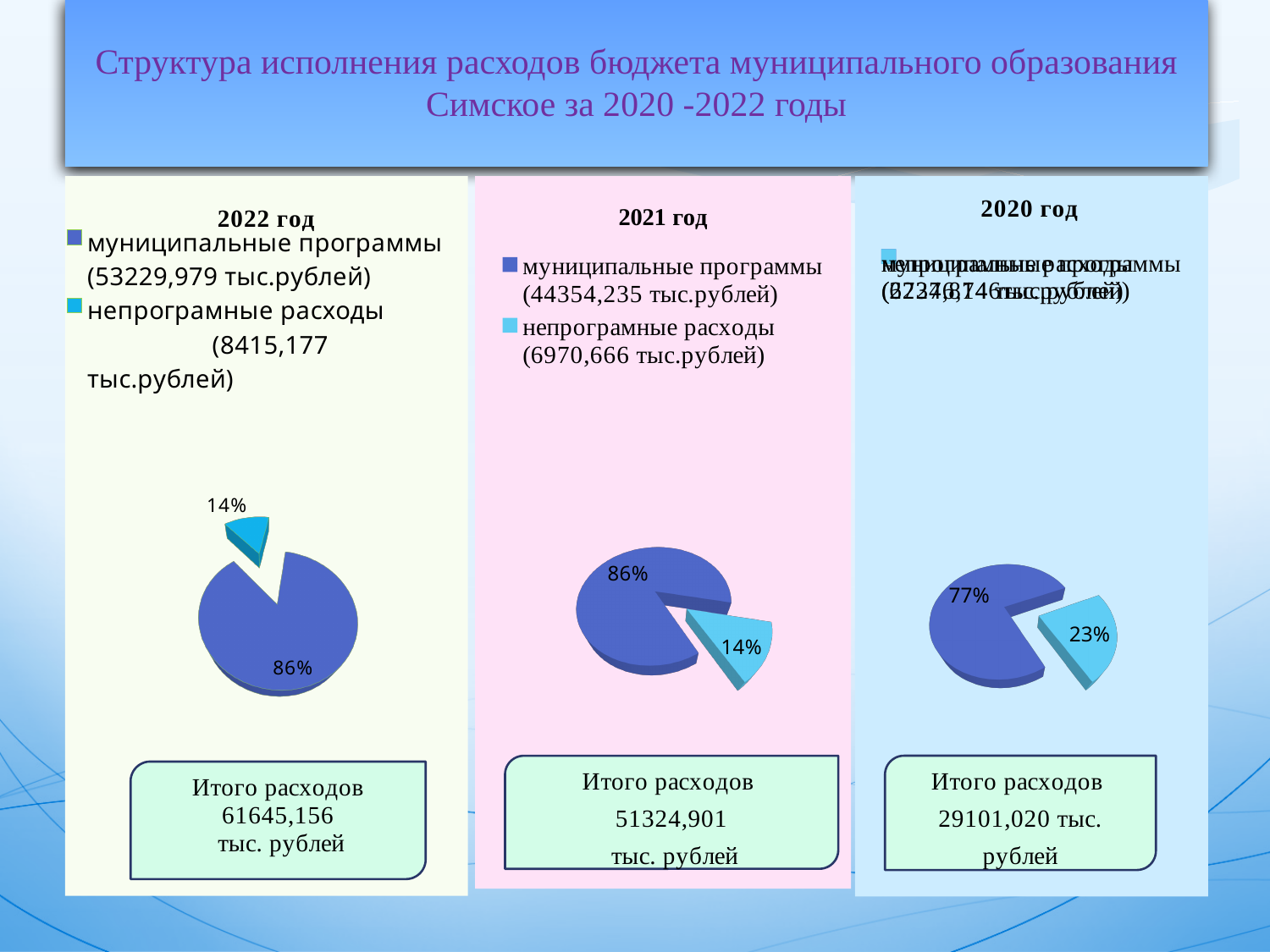
In the 2022 год pie chart, what share is shown for муниципальные программы? 86% In the 2022 год pie chart, what share is shown for непрограмные расходы? 14% In the 2020 год pie chart, what share is shown for the smaller slice? 23% What is the difference in percentage points between the two slices of the 2020 год pie chart? 54 In the 2020 год pie chart, which slice is larger, 77% or 23%? 77% What kind of chart is used for the 2022 год panel? pie chart According to the 2022 год legend, what is the value for муниципальные программы? 53229,979 тыс.рублей How many series does the legend of the 2022 год chart list? 2 According to the 2021 год legend, what is the value for непрограмные расходы? 6970,666 тыс.рублей How many slices does the 2021 год pie chart have? 2